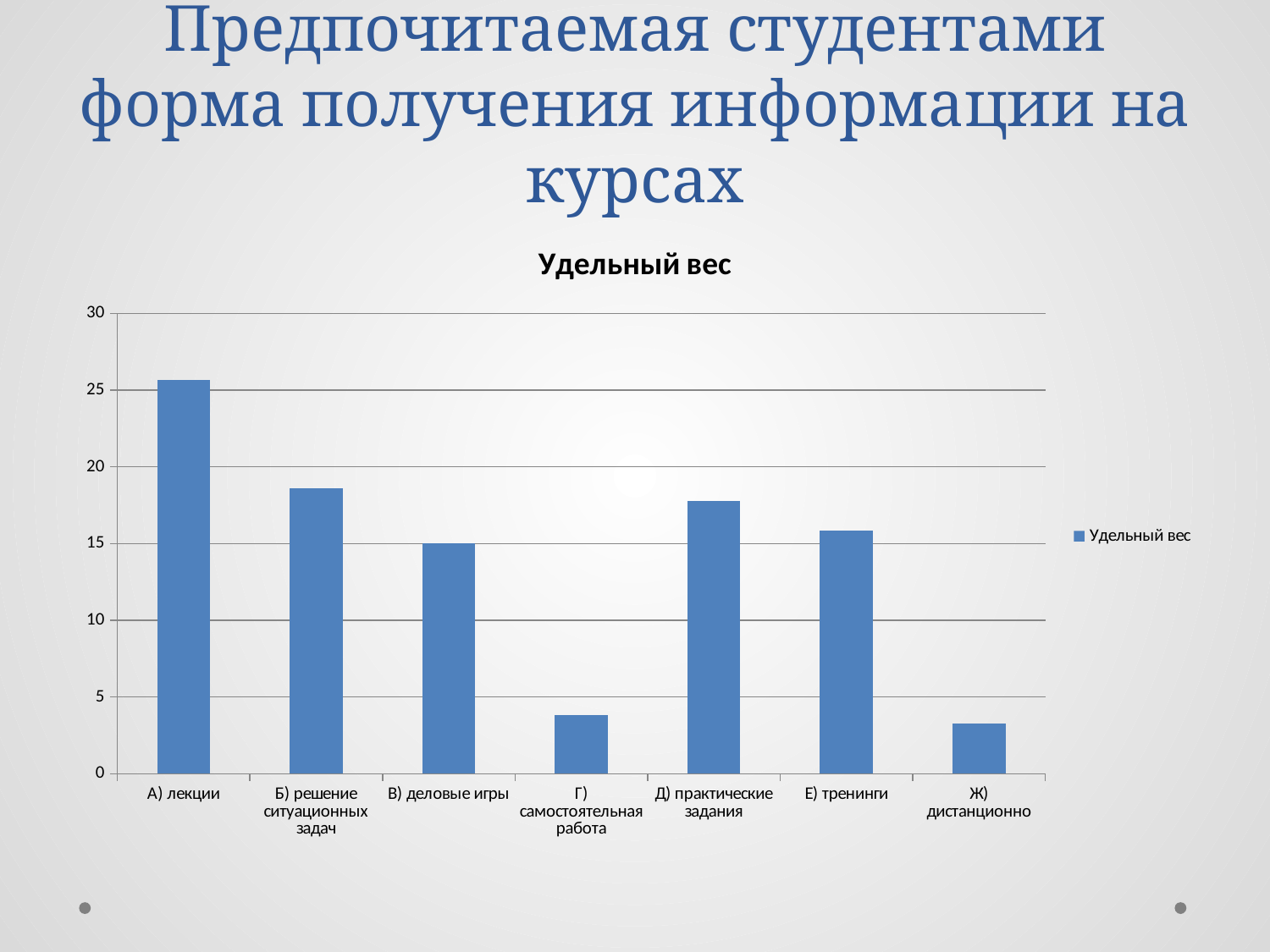
Which category has the highest value? А) лекции Is the value for Г) самостоятельная работа greater or less than 5? less Is the value for Б) решение ситуационных задач greater or less than 20? less Which is larger, the value for Б) решение ситуационных задач or the value for В) деловые игры? Б) решение ситуационных задач Is the value for Д) практические задания greater or less than 15? greater Which is larger, the value for Д) практические задания or the value for Е) тренинги? Д) практические задания What kind of chart is shown on the slide? bar chart What is the title of the chart? Удельный вес How many categories are shown on the x axis of the chart? 7 How many series does the legend list? 1